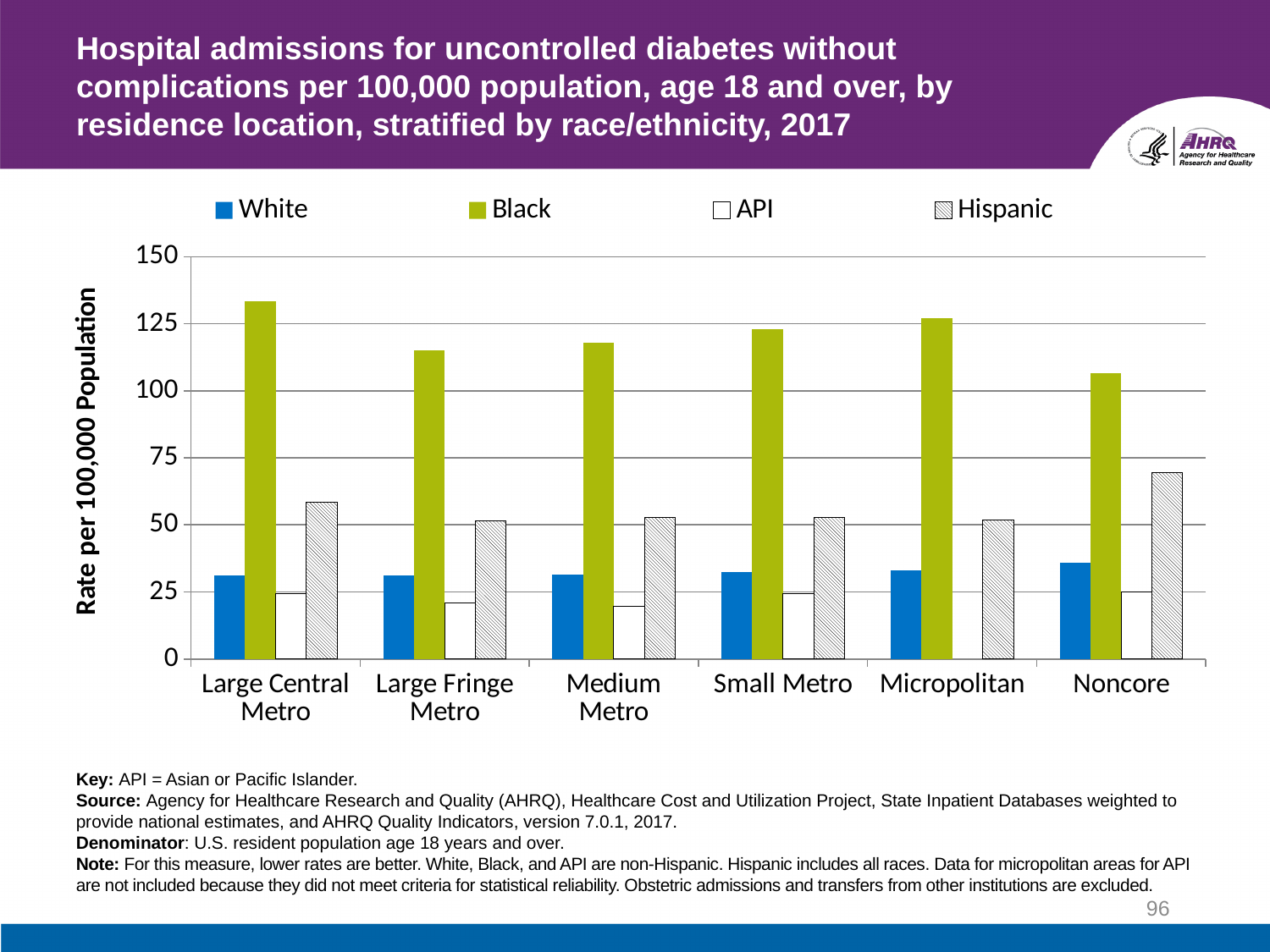
How many series does the legend list? 4 Is the White rate for Large Central Metro greater or less than 50? less In Noncore, which is larger: the Hispanic rate or the White rate? Hispanic Is the Black rate for Large Central Metro greater or less than 125? greater What is the title of the y axis? Rate per 100,000 Population How many residence location categories are shown on the x axis? 6 In which residence location is the Hispanic rate highest? Noncore Is the Hispanic rate for Noncore greater or less than 75? less In which residence location is the Black rate highest? Large Central Metro In which residence location is the Black rate lowest? Noncore Which residence location has no API bar plotted? Micropolitan What kind of chart is shown on the slide? bar chart